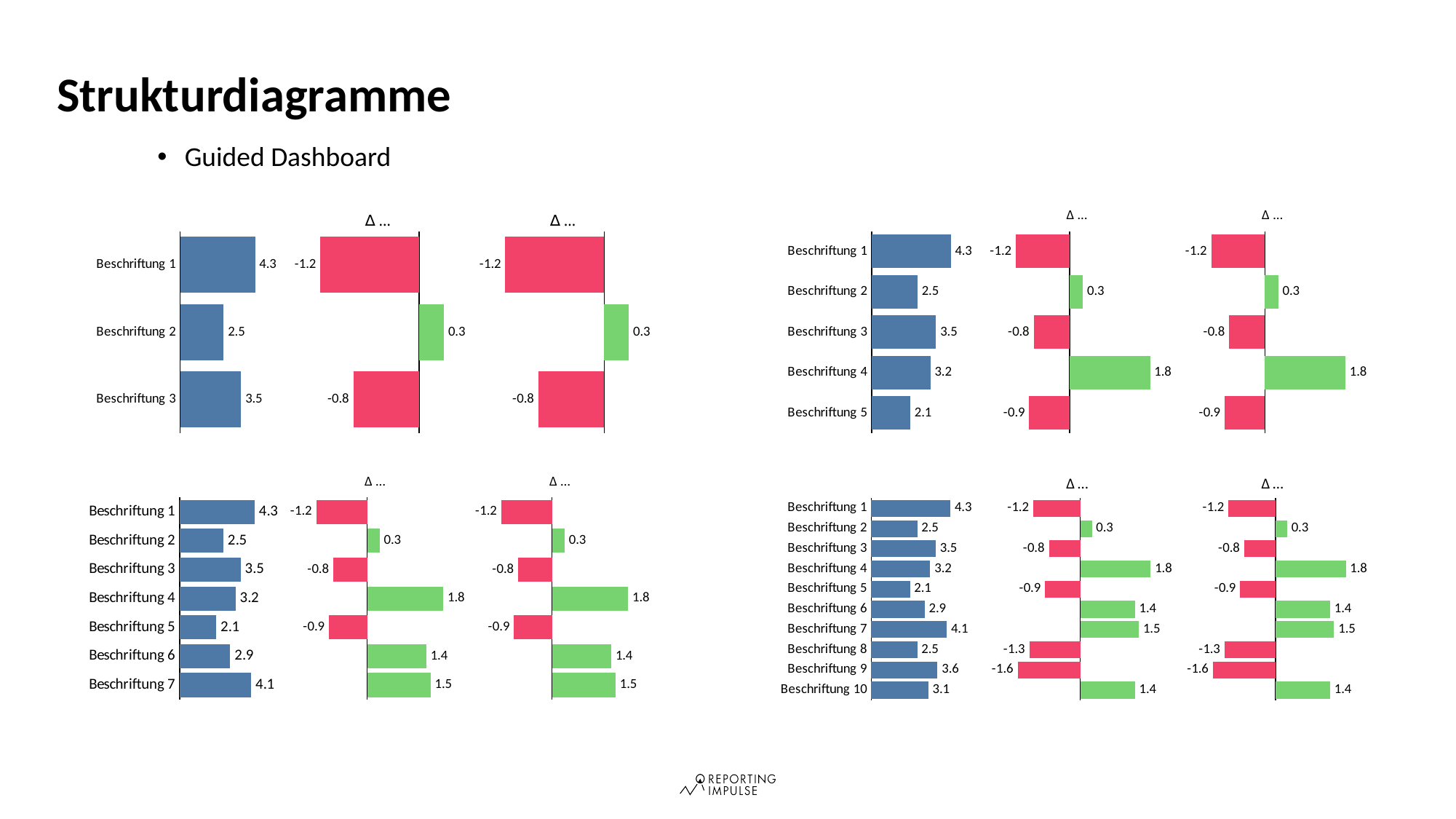
In the bottom-right chart, what is the blue bar value for Beschriftung 10? 3.1 In the bottom-left chart, what is the difference between the blue bar values for Beschriftung 7 and Beschriftung 5? 2.0 What type of chart is used in the top-left group? Bar chart In the top-left chart, what colour are the negative delta bars? Red In the top-right chart, which category has the lowest blue bar value? Beschriftung 5 In the bottom-left chart, how many categories are shown? 7 In the top-left chart, how many categories are shown? 3 In the top-right chart, what is the delta value for Beschriftung 4? 1.8 In the bottom-right chart, which category has the lowest delta value? Beschriftung 9 In the bottom-right chart, how many categories are shown? 10 In the bottom-right chart, which is larger: the blue bar value for Beschriftung 7 or for Beschriftung 9? Beschriftung 7 In the top-left chart, what is the value for Beschriftung 1 in the blue bar series? 4.3